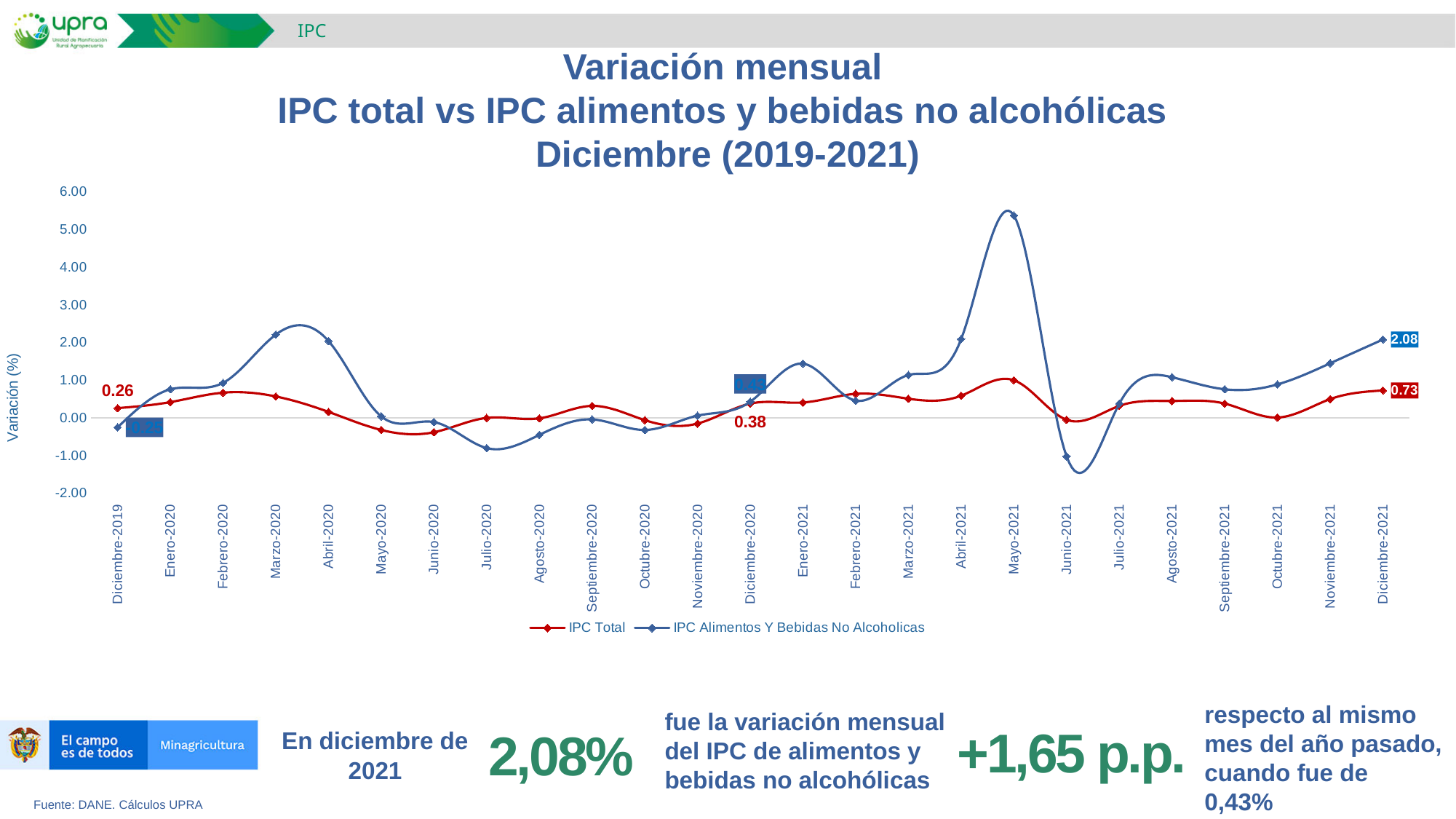
What kind of chart is shown on the slide? line chart What is the value of IPC Total for Diciembre-2020? 0.38 In which month does IPC Alimentos Y Bebidas No Alcoholicas reach its highest value? Mayo-2021 How many months are plotted along the x axis? 25 Is the value of IPC Alimentos Y Bebidas No Alcoholicas for Mayo-2021 greater or less than 5.00? greater What is the value of IPC Total for Diciembre-2021? 0.73 What is the difference between IPC Alimentos Y Bebidas No Alcoholicas and IPC Total in Diciembre-2021? 1.35 How many series does the legend list? 2 By how much did IPC Total in Diciembre-2021 exceed IPC Total in Diciembre-2019? 0.47 What is the value of IPC Alimentos Y Bebidas No Alcoholicas for Diciembre-2021? 2.08 What is the value of IPC Total for Diciembre-2019? 0.26 In Marzo-2020, which series has the higher value, IPC Total or IPC Alimentos Y Bebidas No Alcoholicas? IPC Alimentos Y Bebidas No Alcoholicas